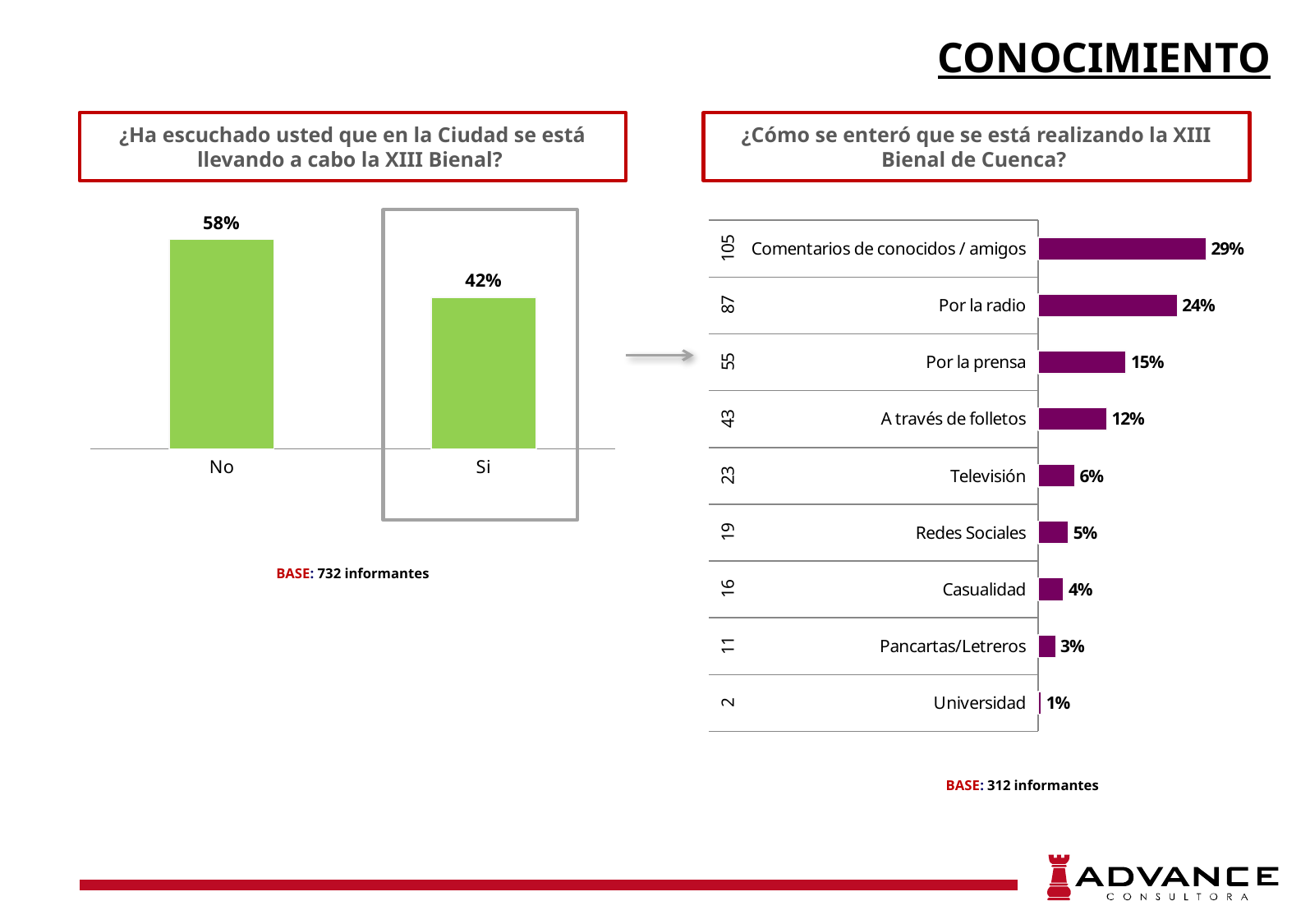
In the right chart, what is the difference between the values for 'Por la prensa' and 'Televisión'? 9% In the right chart, which category has the highest value? Comentarios de conocidos / amigos What is the base (number of informants) stated below the right chart? 312 informantes In the right chart (¿Cómo se enteró que se está realizando la XIII Bienal de Cuenca?), what is the value for 'Por la radio'? 24% In the left chart, what is the difference between the values for 'No' and 'Si'? 16% In the left chart (¿Ha escuchado usted que en la Ciudad se está llevando a cabo la XIII Bienal?), what is the value for 'Si'? 42% What kind of chart is the left chart? Bar chart In the right chart (¿Cómo se enteró que se está realizando la XIII Bienal de Cuenca?), what is the value for 'A través de folletos'? 12% In the left chart (¿Ha escuchado usted que en la Ciudad se está llevando a cabo la XIII Bienal?), what is the value for 'No'? 58% In the right chart, which category has the lowest value? Universidad In the left chart, which category has the higher value, 'No' or 'Si'? No How many categories are shown in the right chart? 9